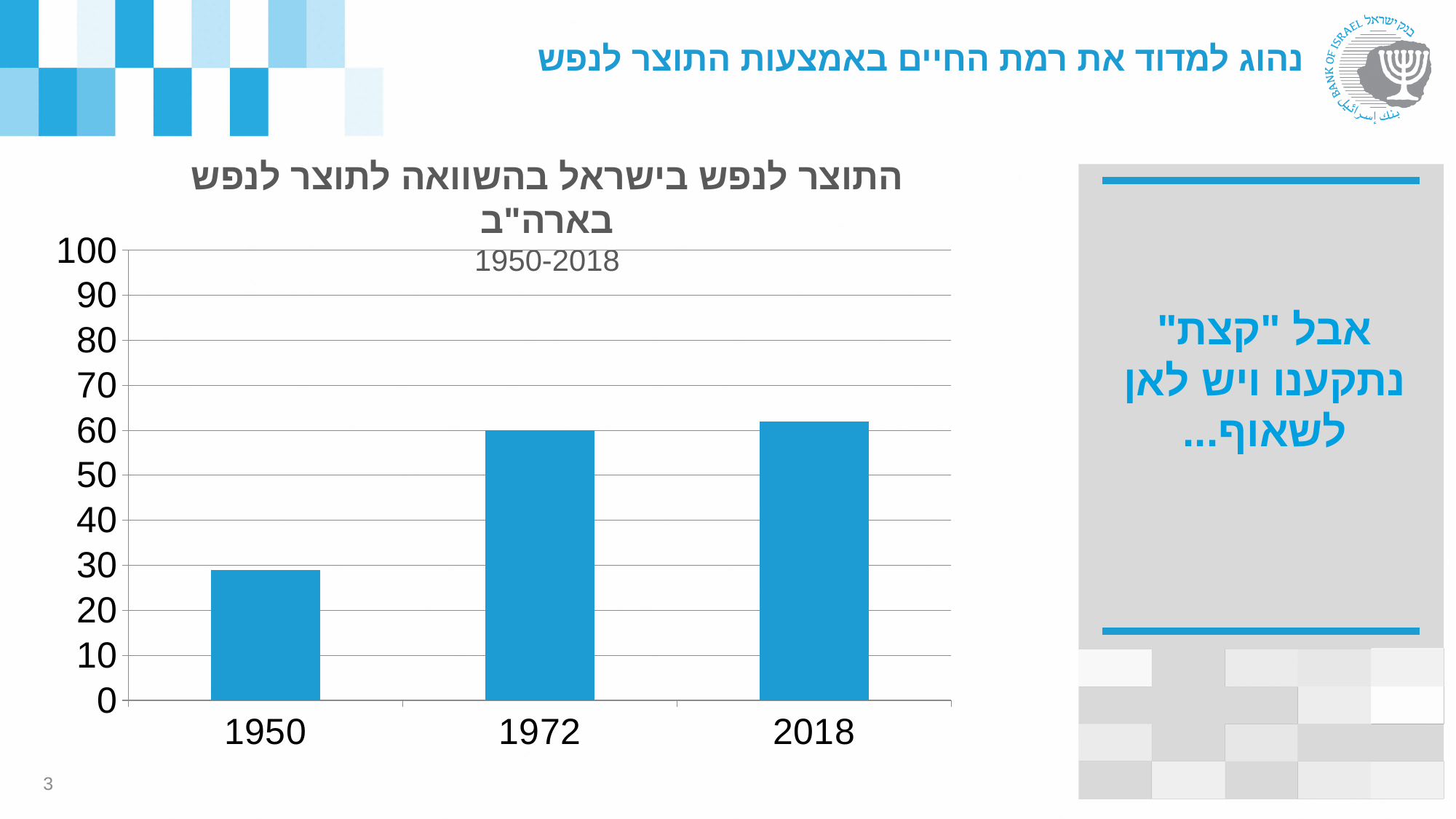
What period is given in the subtitle below the chart title? 1950-2018 Is the value for 2018 greater or less than 50? greater Is the value for 1972 greater or less than 70? less How many bars (years) are plotted in the chart? 3 What kind of chart is shown on the slide? bar chart Is the value for 2018 greater or less than 70? less What is the highest value shown on the chart's vertical axis? 100 Which year has the lowest bar in the chart? 1950 Do the values rise or fall from 1950 to 2018 along the x axis? rise Which is larger, the value for 1950 or the value for 1972? 1972